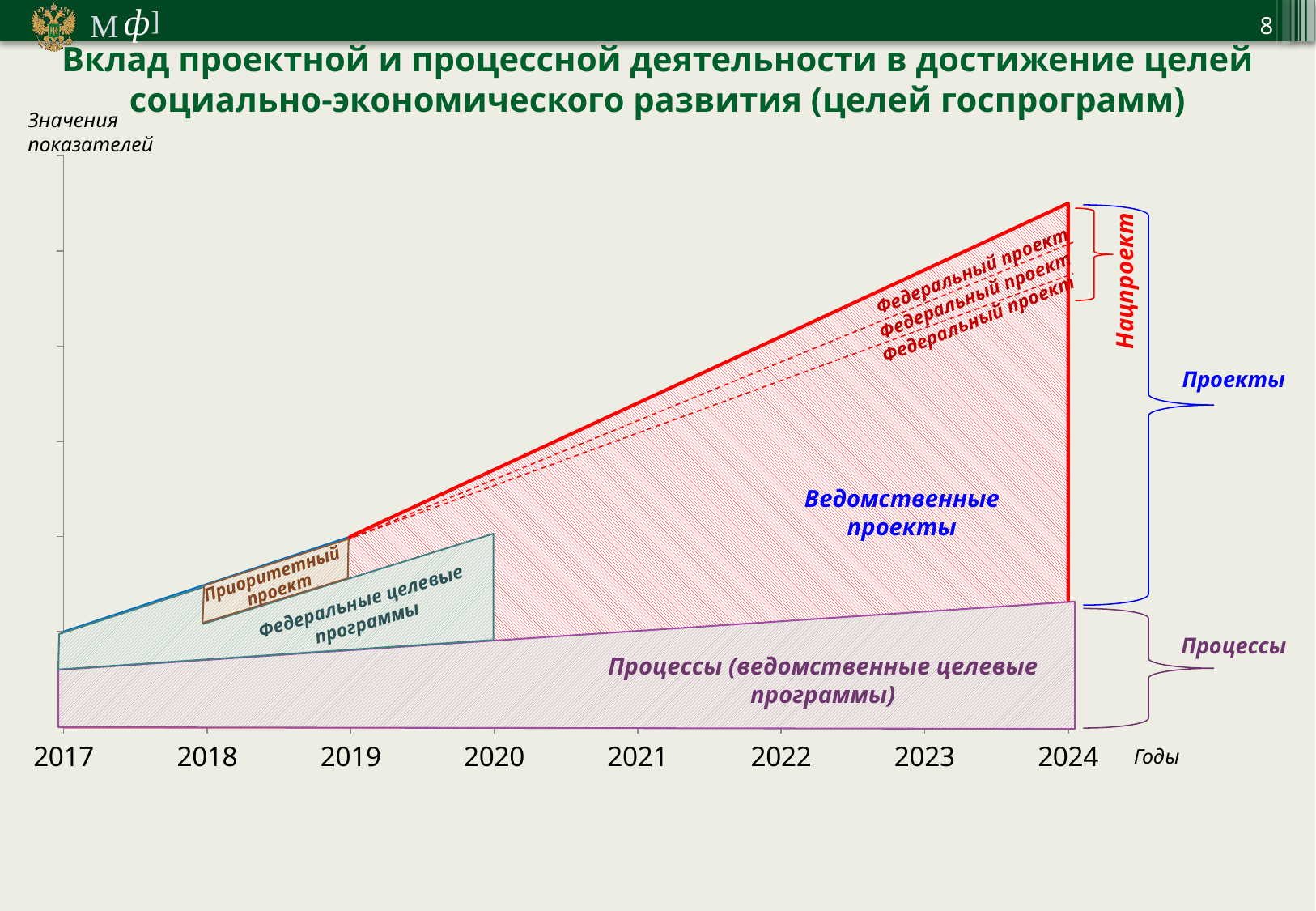
How many years are labelled along the x axis of the chart? 8 Does the purple area labelled 'Процессы (ведомственные целевые программы)' rise or fall from 2017 to 2024? rises What is the first year shown on the x axis of the chart? 2017 What is the label of the y axis of the chart? Значения показателей What is the label of the x axis of the chart? Годы What kind of chart is shown on the slide? area chart What is the last year shown on the x axis of the chart? 2024 Does the red area labelled with federal projects rise or fall from 2019 to 2024? rises